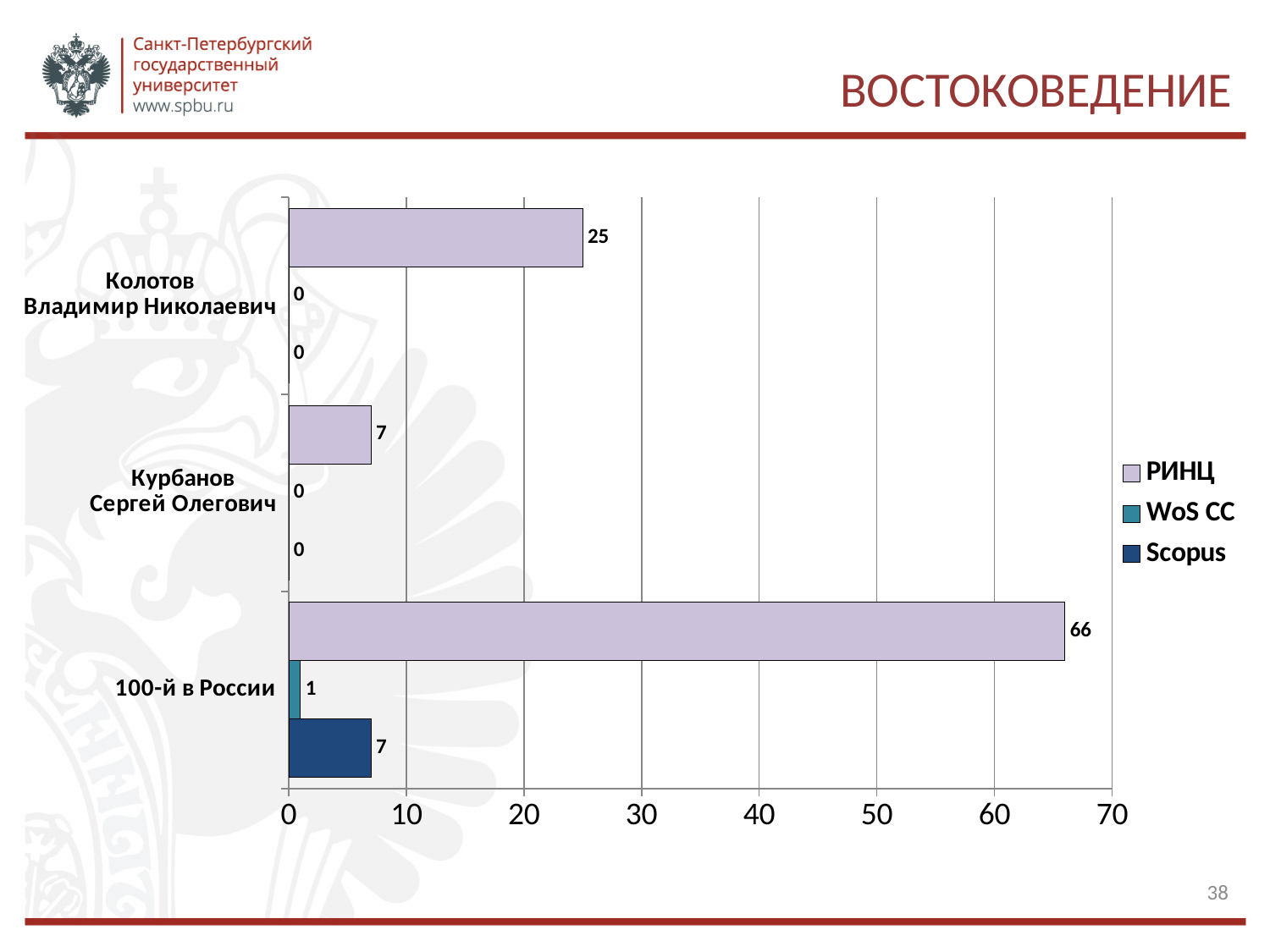
What is the РИНЦ value for Курбанов Сергей Олегович? 7 How many series does the legend list? 3 What is the РИНЦ value for Колотов Владимир Николаевич? 25 Which category has the highest РИНЦ value? 100-й в России What kind of chart is shown on the slide? Bar chart Which category has the lowest РИНЦ value? Курбанов Сергей Олегович What is the WoS CC value for 100-й в России? 1 What is the difference between the РИНЦ values for 100-й в России and Колотов Владимир Николаевич? 41 What is the Scopus value for 100-й в России? 7 What is the Scopus value for Колотов Владимир Николаевич? 0 How many categories are shown on the chart? 3 Which is larger: the РИНЦ value for Колотов Владимир Николаевич or the РИНЦ value for Курбанов Сергей Олегович? Колотов Владимир Николаевич